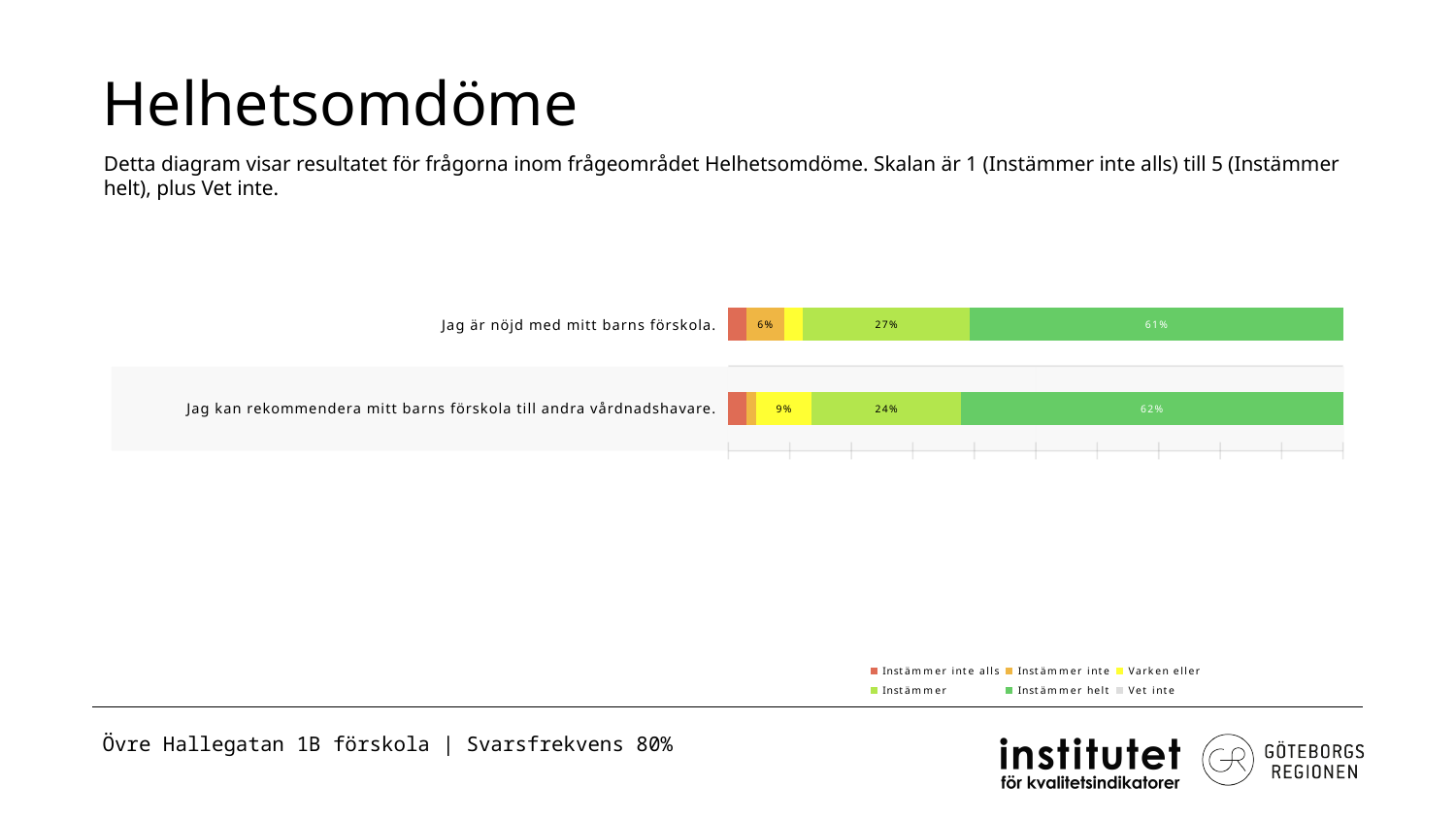
What is the difference in percentage points between the "Instämmer helt" shares of the two statements? 1 What percentage of respondents answered "Varken eller" for "Jag kan rekommendera mitt barns förskola till andra vårdnadshavare."? 9% What percentage of respondents answered "Instämmer inte" for "Jag är nöjd med mitt barns förskola."? 6% Which statement has the larger "Instämmer" share: "Jag är nöjd med mitt barns förskola." or "Jag kan rekommendera mitt barns förskola till andra vårdnadshavare."? Jag är nöjd med mitt barns förskola. What kind of chart is shown on the slide? Stacked bar chart What percentage of respondents answered "Instämmer" for "Jag kan rekommendera mitt barns förskola till andra vårdnadshavare."? 24% What is the difference in percentage points between the "Instämmer" shares of the two statements? 3 How many statements (bars) are shown in the chart? 2 What percentage of respondents answered "Instämmer helt" for "Jag är nöjd med mitt barns förskola."? 61% What percentage of respondents answered "Instämmer helt" for "Jag kan rekommendera mitt barns förskola till andra vårdnadshavare."? 62% What percentage of respondents answered "Instämmer" for "Jag är nöjd med mitt barns förskola."? 27% How many series does the legend list? 6